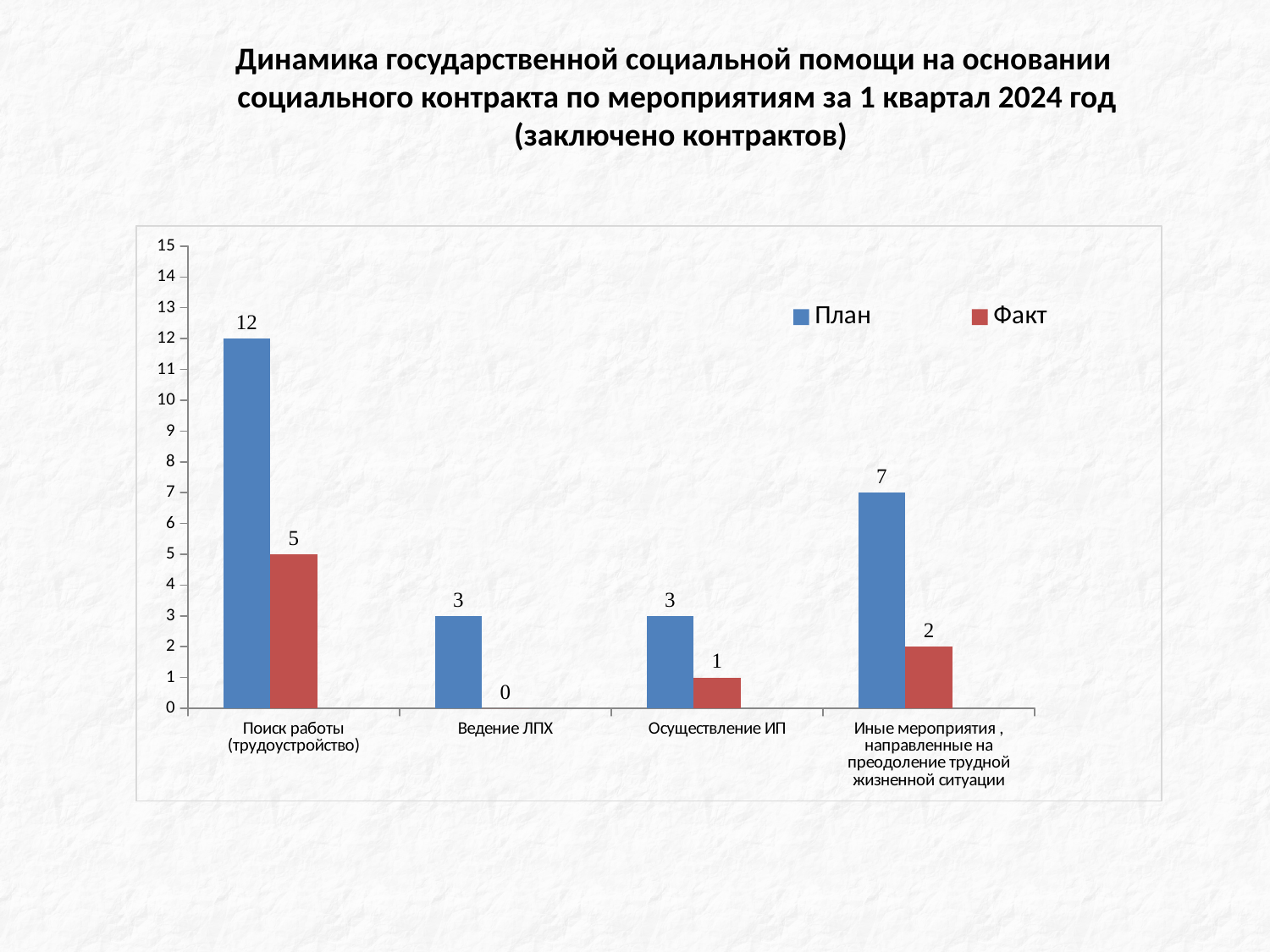
How many categories are shown on the x axis? 4 What is the difference between План and Факт for Поиск работы (трудоустройство)? 7 What is the План value for Поиск работы (трудоустройство)? 12 What is the Факт value for Осуществление ИП? 1 How many series does the legend list? 2 Which is larger: the План value for Иные мероприятия or the План value for Осуществление ИП? Иные мероприятия Which category has the lowest Факт value? Ведение ЛПХ Which colour represents the Факт series in the legend? Red Which category has the highest План value? Поиск работы (трудоустройство) What kind of chart is shown on the slide? Bar chart What is the difference between План and Факт for Иные мероприятия, направленные на преодоление трудной жизненной ситуации? 5 What is the Факт value for Ведение ЛПХ? 0